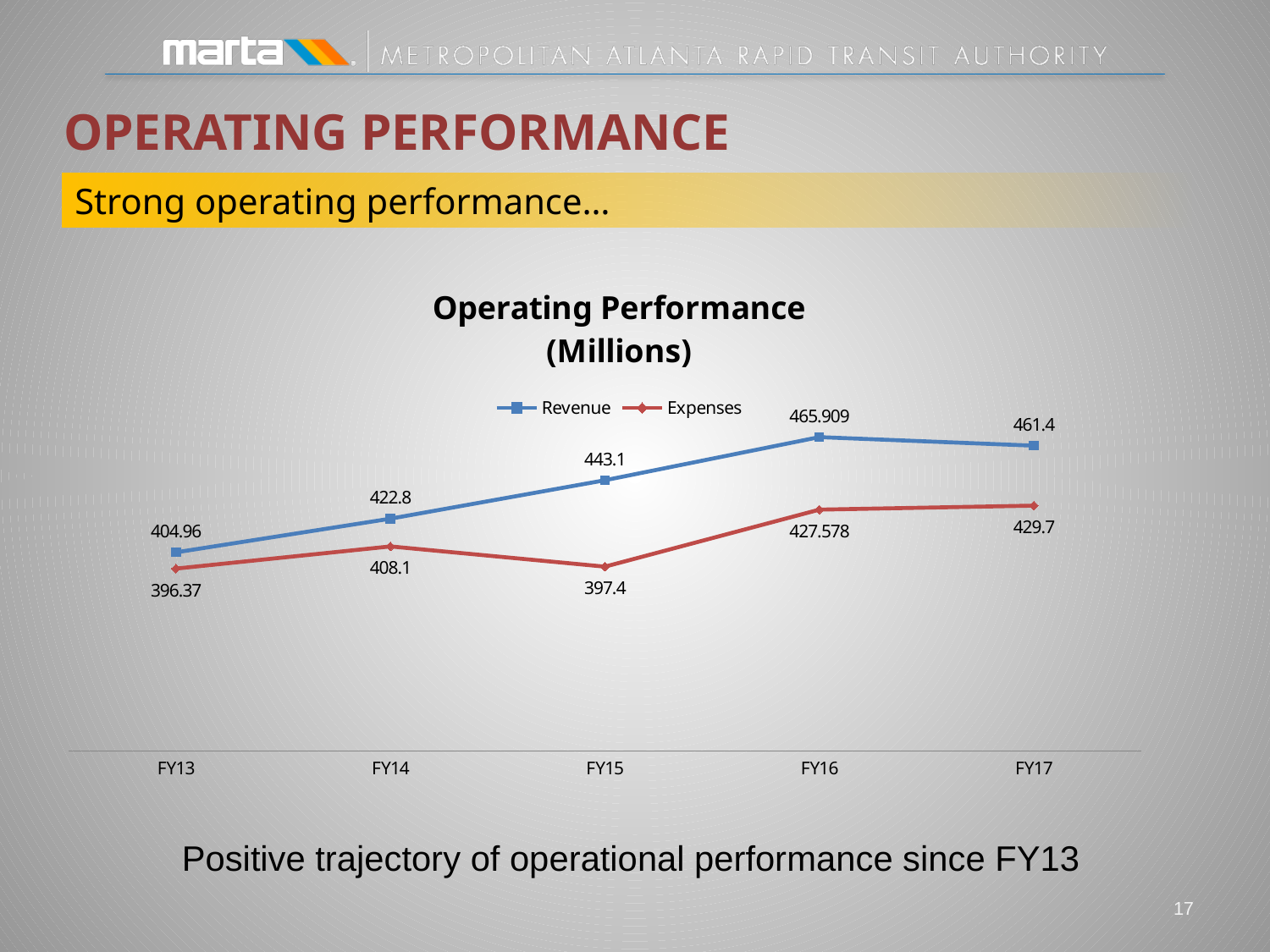
In which fiscal year are Expenses highest? FY17 What is the Revenue value for FY16? 465.909 How many fiscal years are shown on the x axis? 5 In which fiscal year is Revenue lowest? FY13 What type of chart is shown on the slide? Line chart Which is larger in FY15, Revenue or Expenses? Revenue What is the Revenue value for FY15? 443.1 By how much did Revenue increase from FY13 to FY17? 56.44 In which fiscal year is Revenue highest? FY16 What is the difference between Revenue and Expenses in FY16? 38.331 How many series does the legend list? 2 What is the Expenses value for FY14? 408.1